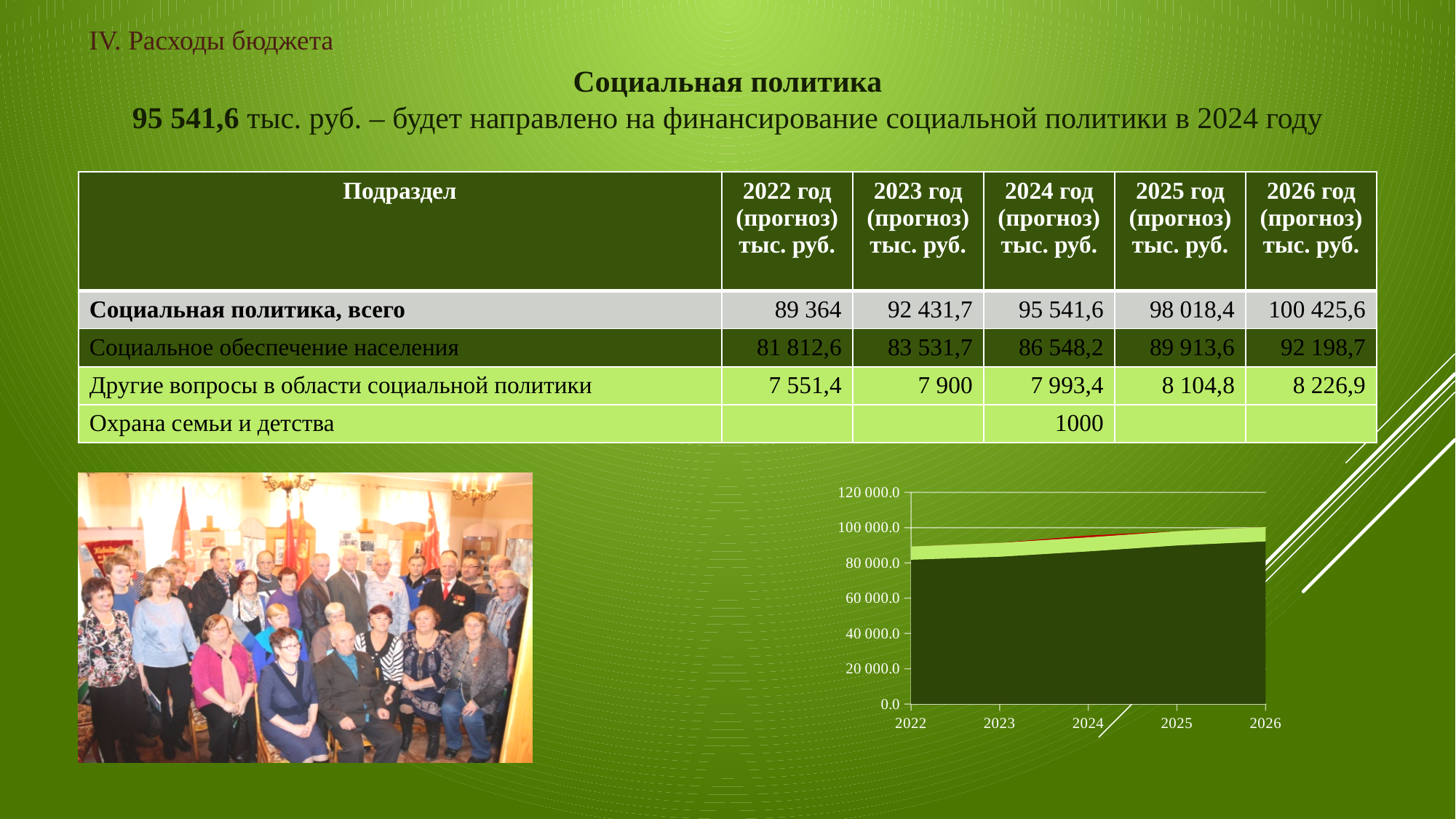
Is the dark green (bottom) area for 2022 greater or less than 60 000.0? greater Is the dark green (bottom) area for 2026 greater or less than 100 000.0? less Is the dark green (bottom) area for 2026 greater or less than 80 000.0? greater How many years are shown along the x axis of the chart? 5 What is the highest value shown on the chart's y axis? 120 000.0 Which year has the highest total in the chart? 2026 Do the values in the chart rise or fall from 2022 to 2026? rise What kind of chart is shown on the slide? area chart Which year has the lowest total in the chart? 2022